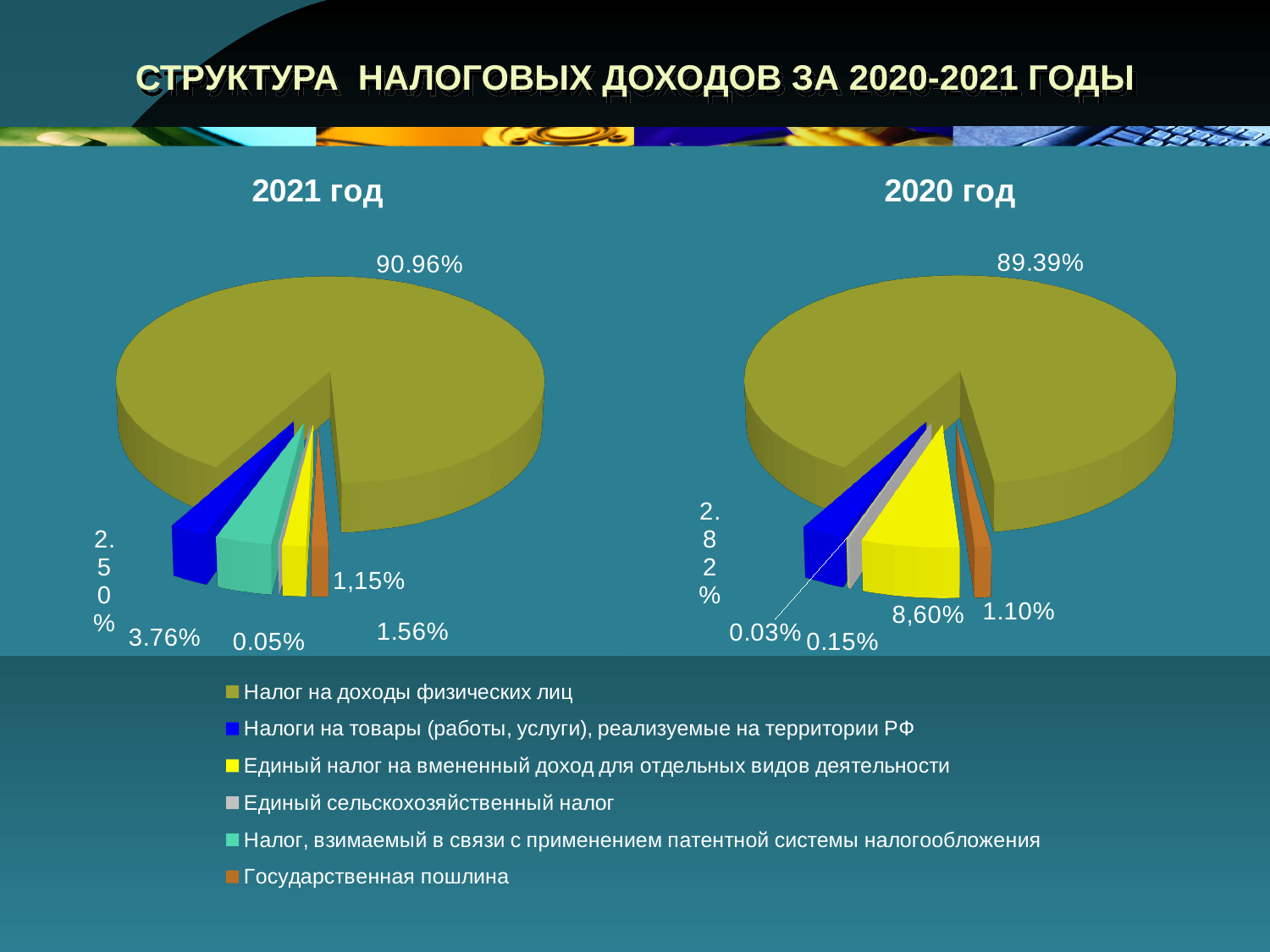
Which chart has the larger share for Налог на доходы физических лиц, "2021 год" or "2020 год"? 2021 год Which legend entry corresponds to the largest slice in both pie charts? Налог на доходы физических лиц In the "2020 год" chart, what share is shown for the largest slice (Налог на доходы физических лиц)? 89.39% In the "2021 год" chart, what is the smallest labelled share? 0.05% By how many percentage points does the largest slice in the "2021 год" chart (90.96%) exceed the largest slice in the "2020 год" chart (89.39%)? 1.57 What kind of charts are shown on the slide? Pie charts In the "2020 год" chart, what share is labelled on the yellow slice (Единый налог на вмененный доход)? 8,60% In the "2020 год" chart, what is the smallest labelled share? 0.03% How many entries does the shared legend list? 6 In the "2021 год" chart, what share is shown for the largest slice (Налог на доходы физических лиц)? 90.96%